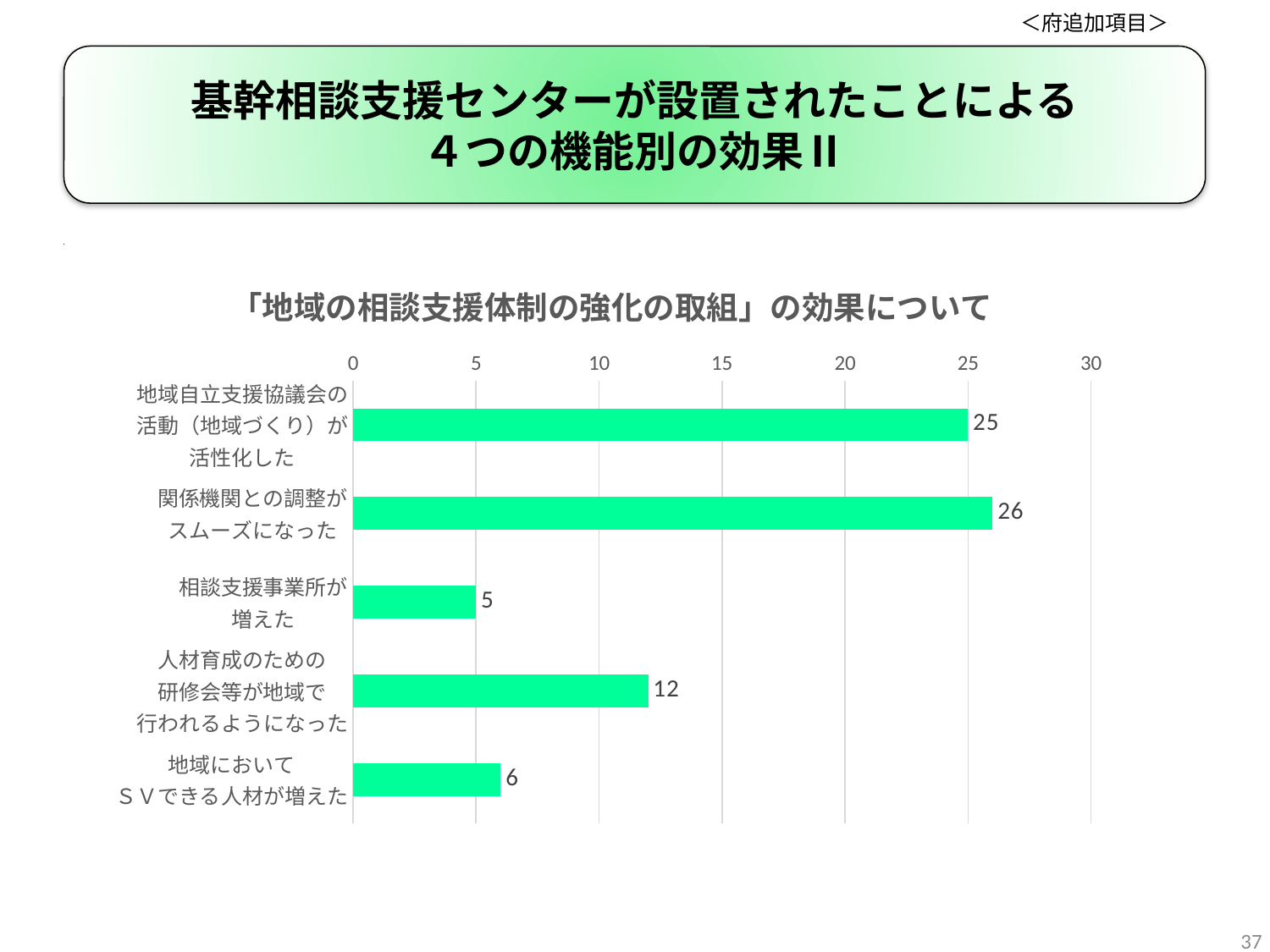
What is the difference between the values for 関係機関との調整がスムーズになった and 地域自立支援協議会の活動（地域づくり）が活性化した? 1 What is the value for 関係機関との調整がスムーズになった? 26 What is the value for 相談支援事業所が増えた? 5 Is the value for 地域自立支援協議会の活動（地域づくり）が活性化した greater or less than 20? greater Which is larger: the value for 人材育成のための研修会等が地域で行われるようになった or the value for 地域においてＳＶできる人材が増えた? 人材育成のための研修会等が地域で行われるようになった Which category has the highest value? 関係機関との調整がスムーズになった How many categories are shown in the chart? 5 What is the title of the chart? 「地域の相談支援体制の強化の取組」の効果について What is the value for 地域においてＳＶできる人材が増えた? 6 Which category has the lowest value? 相談支援事業所が増えた What kind of chart is shown on the slide? bar chart What is the value for 人材育成のための研修会等が地域で行われるようになった? 12